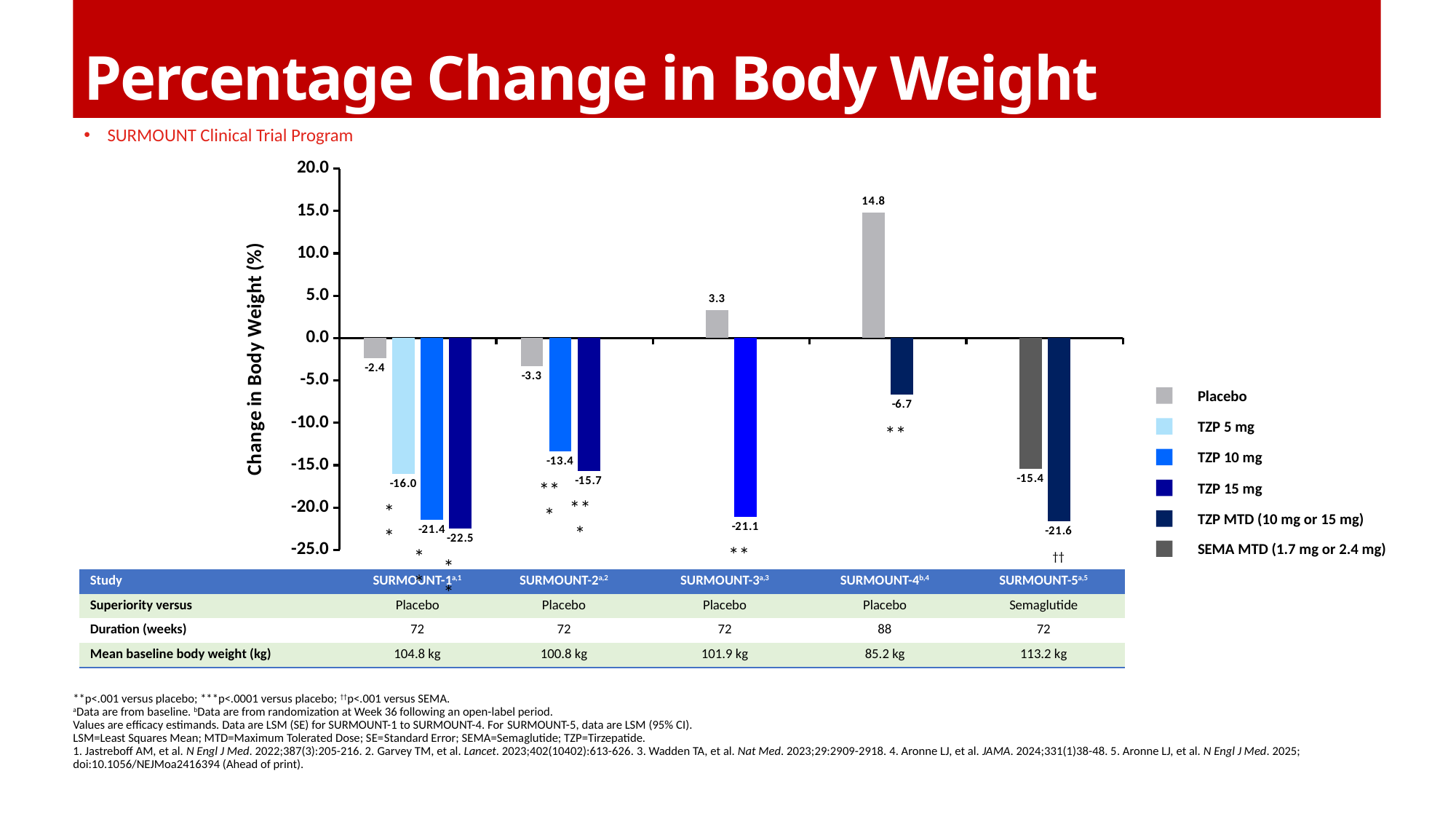
What is the percentage change in body weight for the SEMA MTD group in SURMOUNT-5? -15.4 What is the difference between the TZP 15 mg and placebo values in SURMOUNT-2? 12.4 What is the percentage change in body weight for the TZP 15 mg group in SURMOUNT-1? -22.5 Which bar on the chart has the lowest value? TZP 15 mg in SURMOUNT-1 (-22.5) What is the percentage change in body weight for the placebo group in SURMOUNT-4? 14.8 Which is larger in value, the placebo bar in SURMOUNT-3 or the placebo bar in SURMOUNT-4? SURMOUNT-4 What is the difference between the TZP MTD and SEMA MTD values in SURMOUNT-5? 6.2 What is the percentage change in body weight for the TZP 10 mg group in SURMOUNT-2? -13.4 What type of chart is shown on the slide? Bar chart Which study shows the largest placebo value on the chart? SURMOUNT-4 How many studies are shown along the x axis of the chart? 5 How many series does the chart legend list? 6